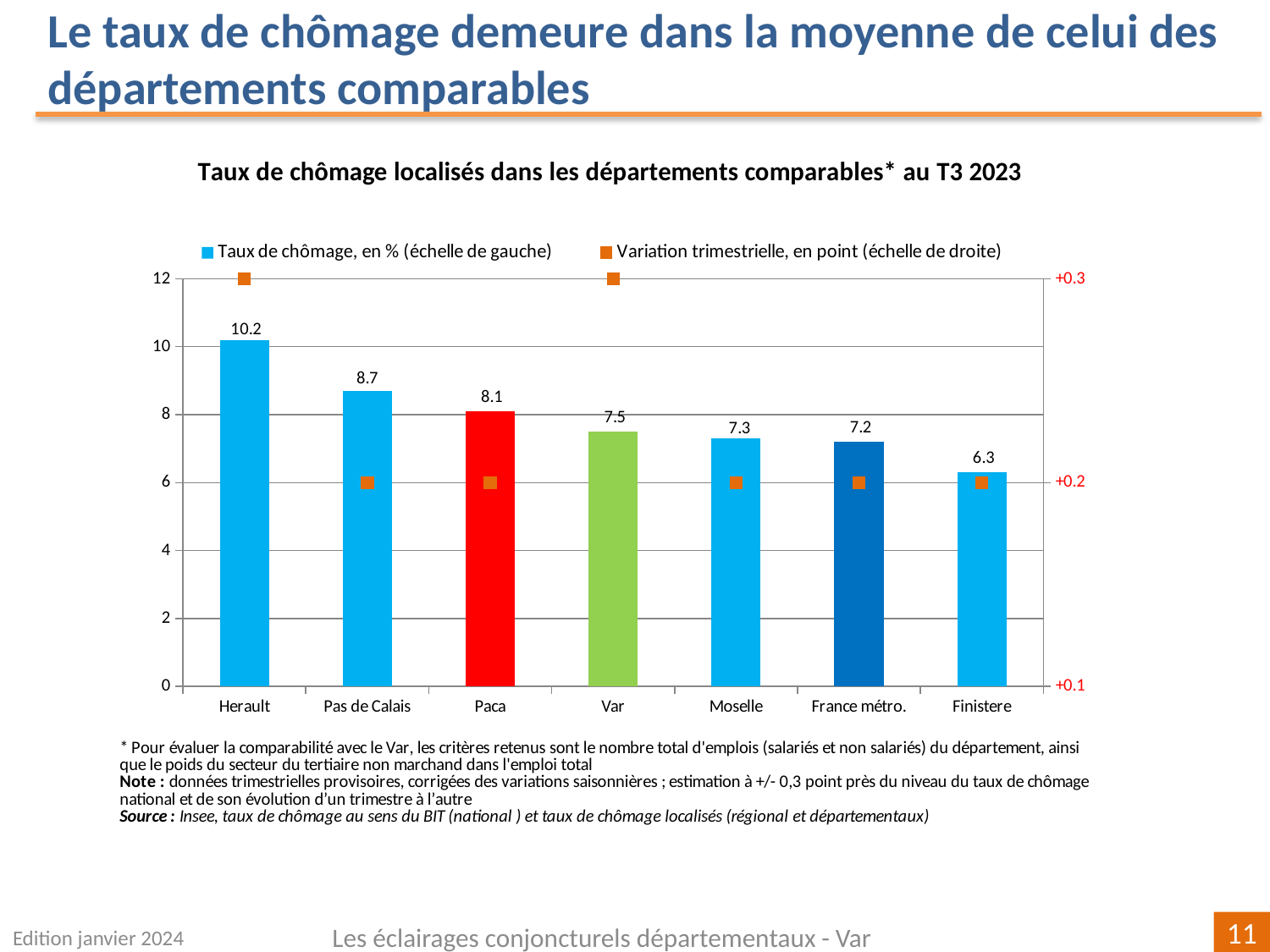
Which has a higher unemployment rate, Pas de Calais or Paca? Pas de Calais How many series does the legend list? 2 What is the unemployment rate (Taux de chômage) for France métro.? 7.2 What is the quarterly variation (Variation trimestrielle) for Var, read on the right-hand axis? +0.3 What is the unemployment rate (Taux de chômage) for Var? 7.5 How many categories are shown on the x axis? 7 What kind of chart is this? Bar chart What is the title of the chart? Taux de chômage localisés dans les départements comparables* au T3 2023 Which category has the lowest unemployment rate? Finistere What is the unemployment rate (Taux de chômage) for Herault? 10.2 Which department has the highest unemployment rate? Herault What is the difference between the unemployment rates of Herault and Finistere? 3.9